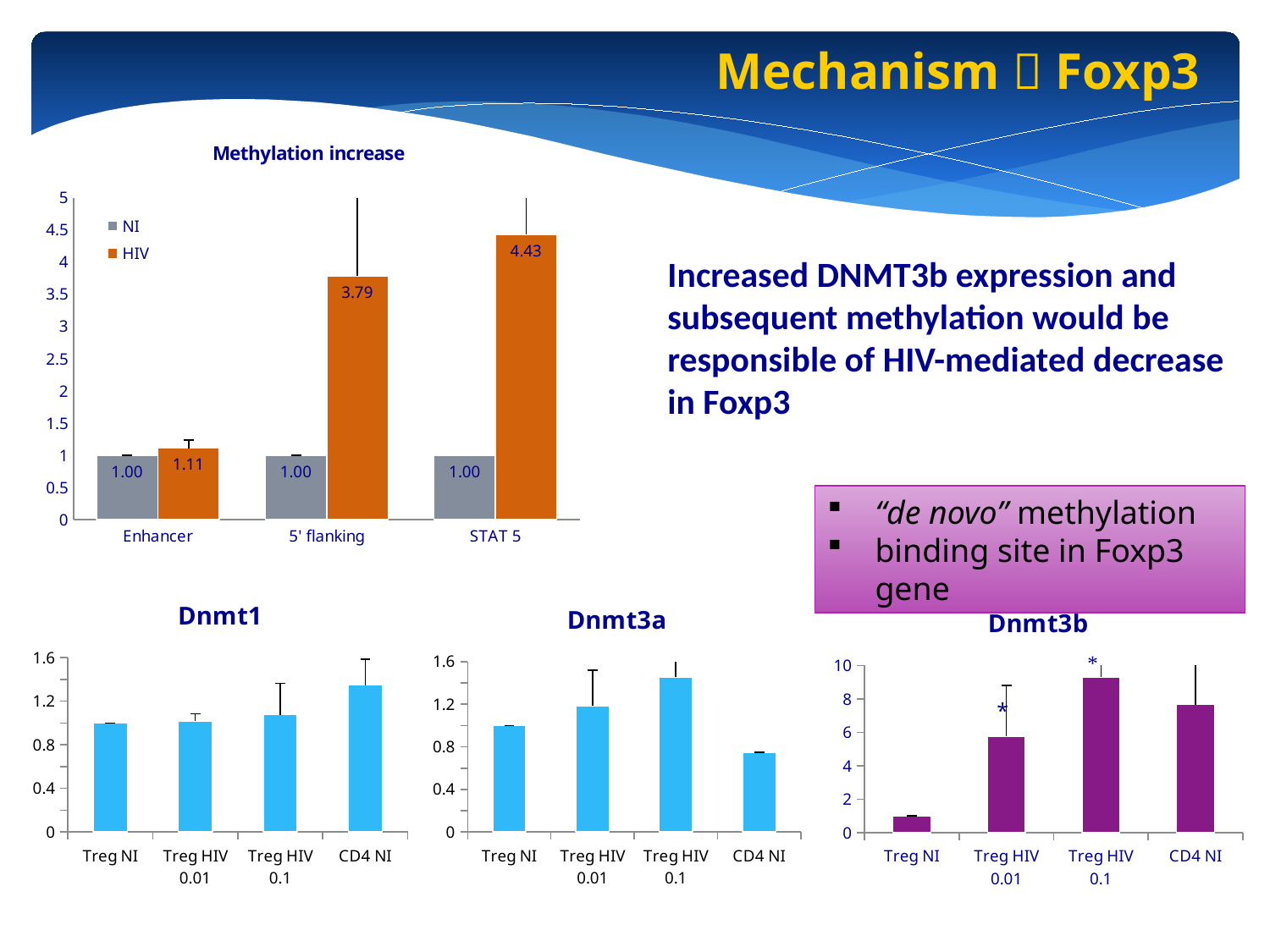
In the Methylation increase chart, what is the HIV value for Enhancer? 1.11 In the Methylation increase chart, what is the HIV value for 5' flanking? 3.79 In the Methylation increase chart, what is the difference between the HIV and NI values for STAT 5? 3.43 What kind of chart is the Dnmt3b chart? bar chart In the Methylation increase chart, what is the HIV value for STAT 5? 4.43 In the Methylation increase chart, how many series does the legend list? 2 In the Dnmt3b chart, is the value for Treg HIV 0.01 greater or less than 4? greater In the Methylation increase chart, which category has the highest HIV value? STAT 5 In the Dnmt1 chart, is the value for CD4 NI greater or less than 1.2? greater In the Dnmt3b chart, which category has the highest value? Treg HIV 0.1 In the Dnmt3a chart, which category has the lowest value? CD4 NI In the Methylation increase chart, how many categories are shown on the x axis? 3